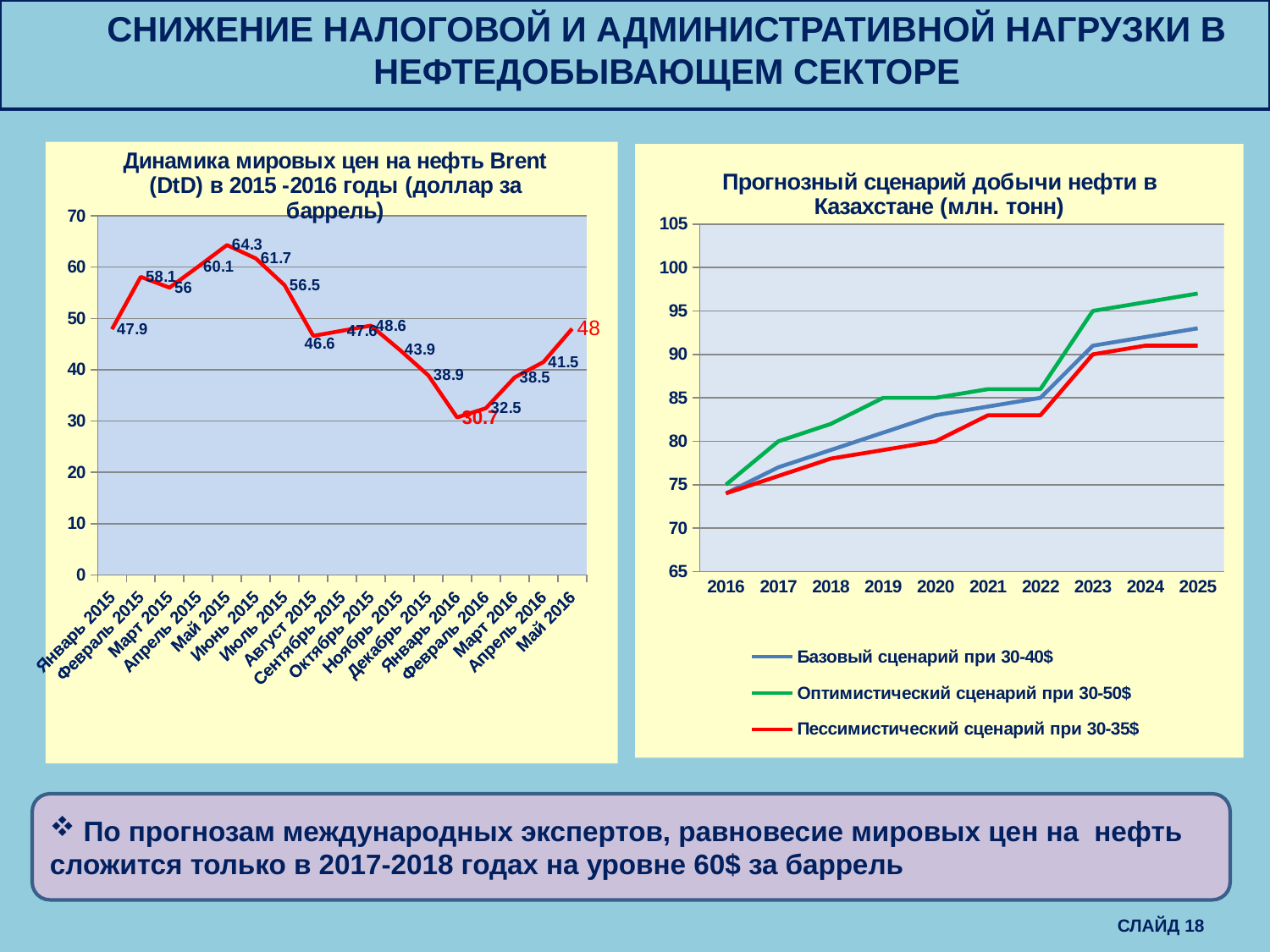
In the left chart 'Динамика мировых цен на нефть Brent', what is the value for Май 2016? 48 How many series does the legend of the right chart 'Прогнозный сценарий добычи нефти в Казахстане' list? 3 What kind of chart is the left chart, 'Динамика мировых цен на нефть Brent'? line chart In the left chart 'Динамика мировых цен на нефть Brent', what is the value for Август 2015? 46.6 In the left chart 'Динамика мировых цен на нефть Brent', which month has the highest value? Май 2015 In the left chart 'Динамика мировых цен на нефть Brent', what is the difference between the values for Май 2015 and Январь 2016? 33.6 In the right chart 'Прогнозный сценарий добычи нефти в Казахстане', is the value of the Оптимистический сценарий при 30-50$ in 2025 greater or less than 95? greater In the right chart 'Прогнозный сценарий добычи нефти в Казахстане', which scenario has the highest value in 2025? Оптимистический сценарий при 30-50$ In the left chart 'Динамика мировых цен на нефть Brent', which month has the lowest value? Январь 2016 In the right chart 'Прогнозный сценарий добычи нефти в Казахстане', do the values of the Базовый сценарий при 30-40$ rise or fall from 2016 to 2025? rise How many months are plotted in the left chart 'Динамика мировых цен на нефть Brent'? 17 In the left chart 'Динамика мировых цен на нефть Brent', which is larger: the value for Февраль 2015 or Март 2015? Февраль 2015